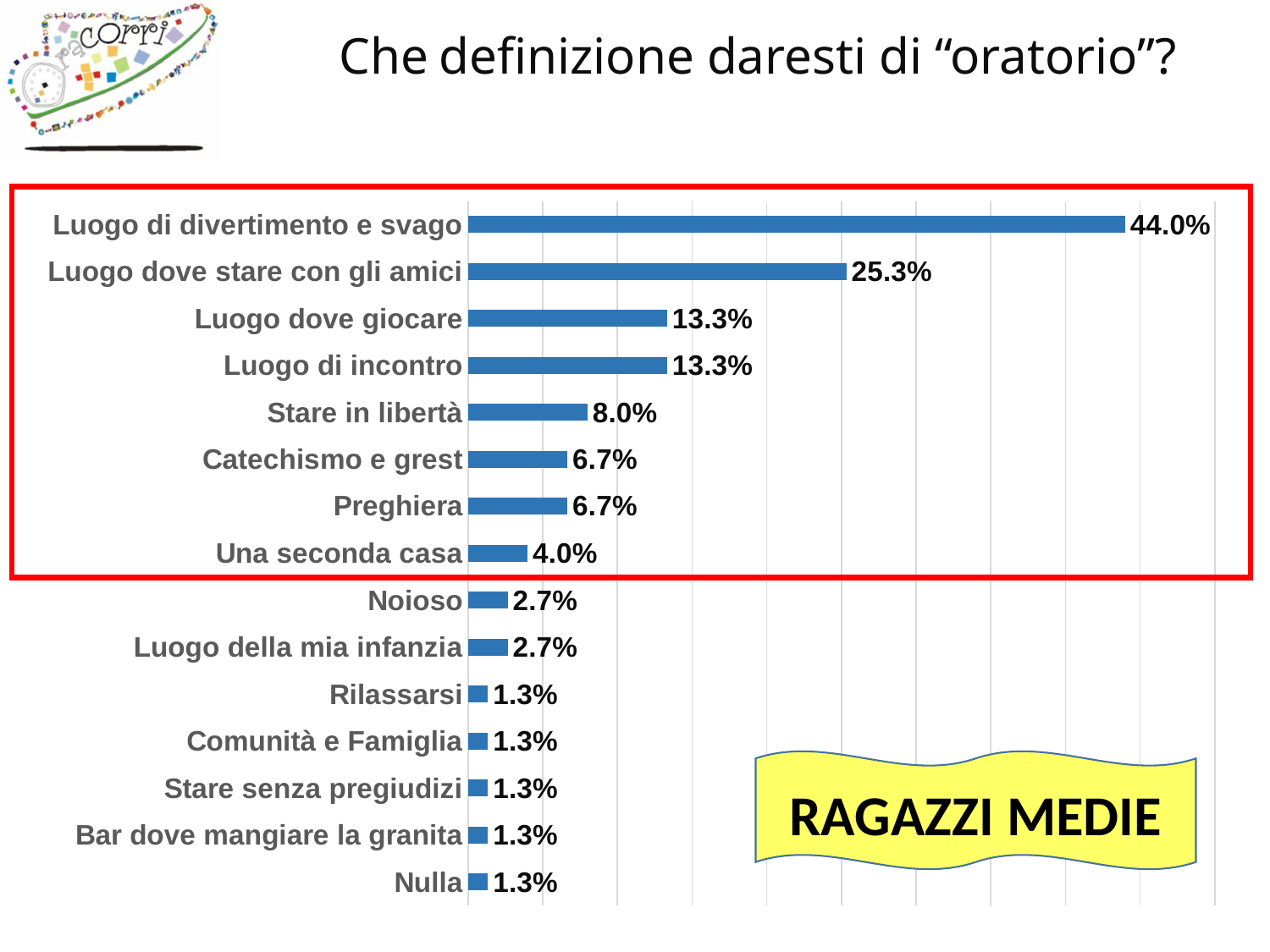
What type of chart is shown on the slide? Bar chart What is the difference between the values for "Luogo di divertimento e svago" and "Luogo dove stare con gli amici"? 18.7% What is the difference between the values for "Luogo dove giocare" and "Catechismo e grest"? 6.6% Which is larger, the value for "Stare in libertà" or the value for "Preghiera"? Stare in libertà Which category has the highest value? Luogo di divertimento e svago How many categories are shown in the chart? 15 What is the title of the slide above the chart? Che definizione daresti di "oratorio"? What is the value for "Una seconda casa"? 4.0% What is the value for "Luogo dove stare con gli amici"? 25.3% What is the value for "Noioso"? 2.7% What is the value for "Stare in libertà"? 8.0% What is the value for "Luogo di divertimento e svago"? 44.0%